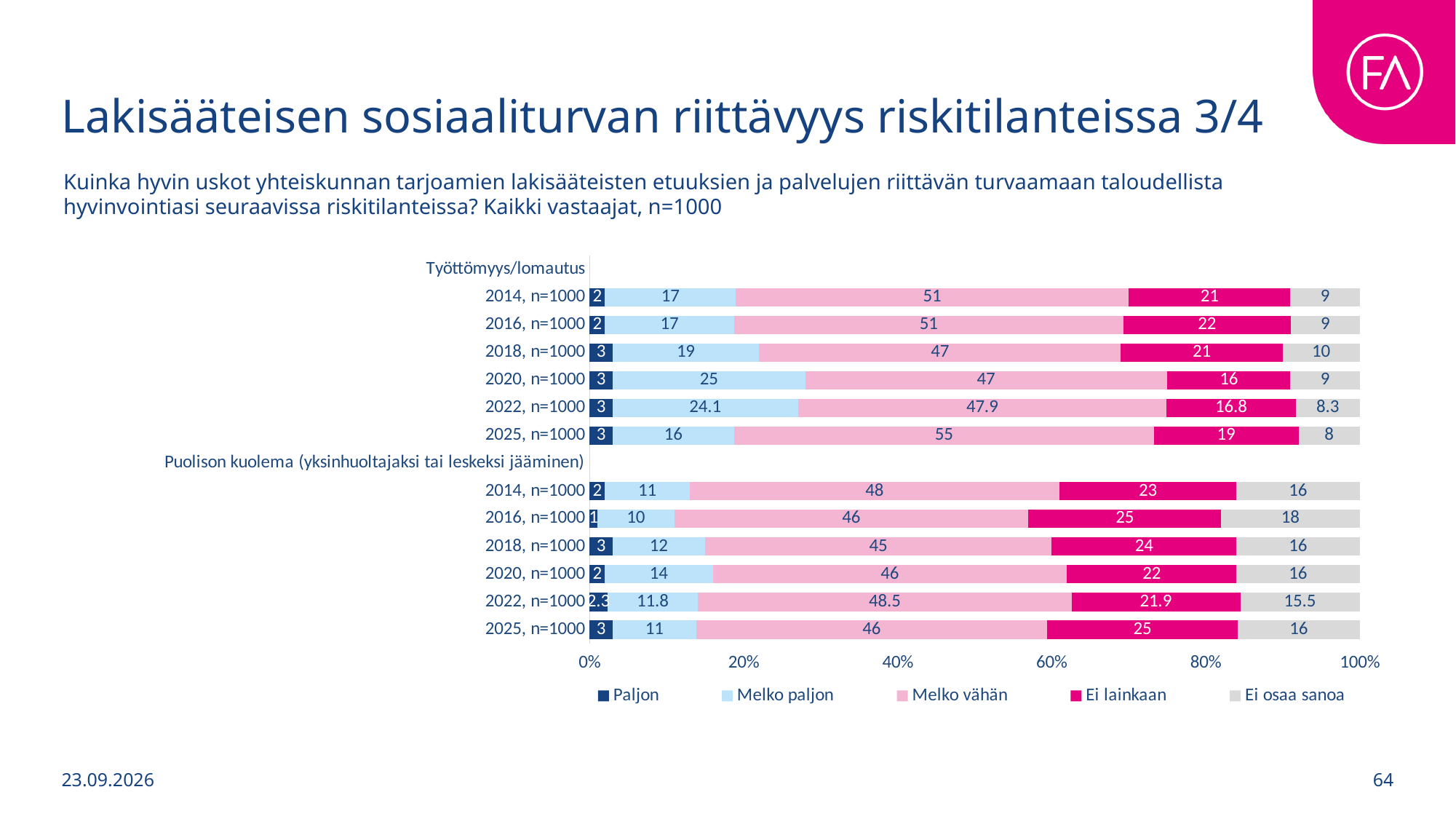
Among the Puolison kuolema bars, which year has the lowest 'Paljon' value? 2016, n=1000 How many year bars are shown for the Puolison kuolema group? 6 What is the difference between the 'Ei lainkaan' values for Työttömyys/lomautus in 2016 and 2020? 6 What is the 'Melko paljon' value for Työttömyys/lomautus in 2020, n=1000? 25 Among the Työttömyys/lomautus bars, which year has the highest 'Melko vähän' value? 2025, n=1000 What is the 'Ei lainkaan' value for Puolison kuolema in 2022, n=1000? 21.9 What is the 'Melko vähän' value for Työttömyys/lomautus in 2025, n=1000? 55 How many series does the legend list? 5 Which is larger: the 'Melko paljon' value for Työttömyys/lomautus in 2018 or for Puolison kuolema in 2018? Työttömyys/lomautus in 2018 What is the 'Ei osaa sanoa' value for Puolison kuolema in 2016, n=1000? 18 What kind of chart is shown on the slide? stacked bar chart Which legend entry is shown in dark blue? Paljon